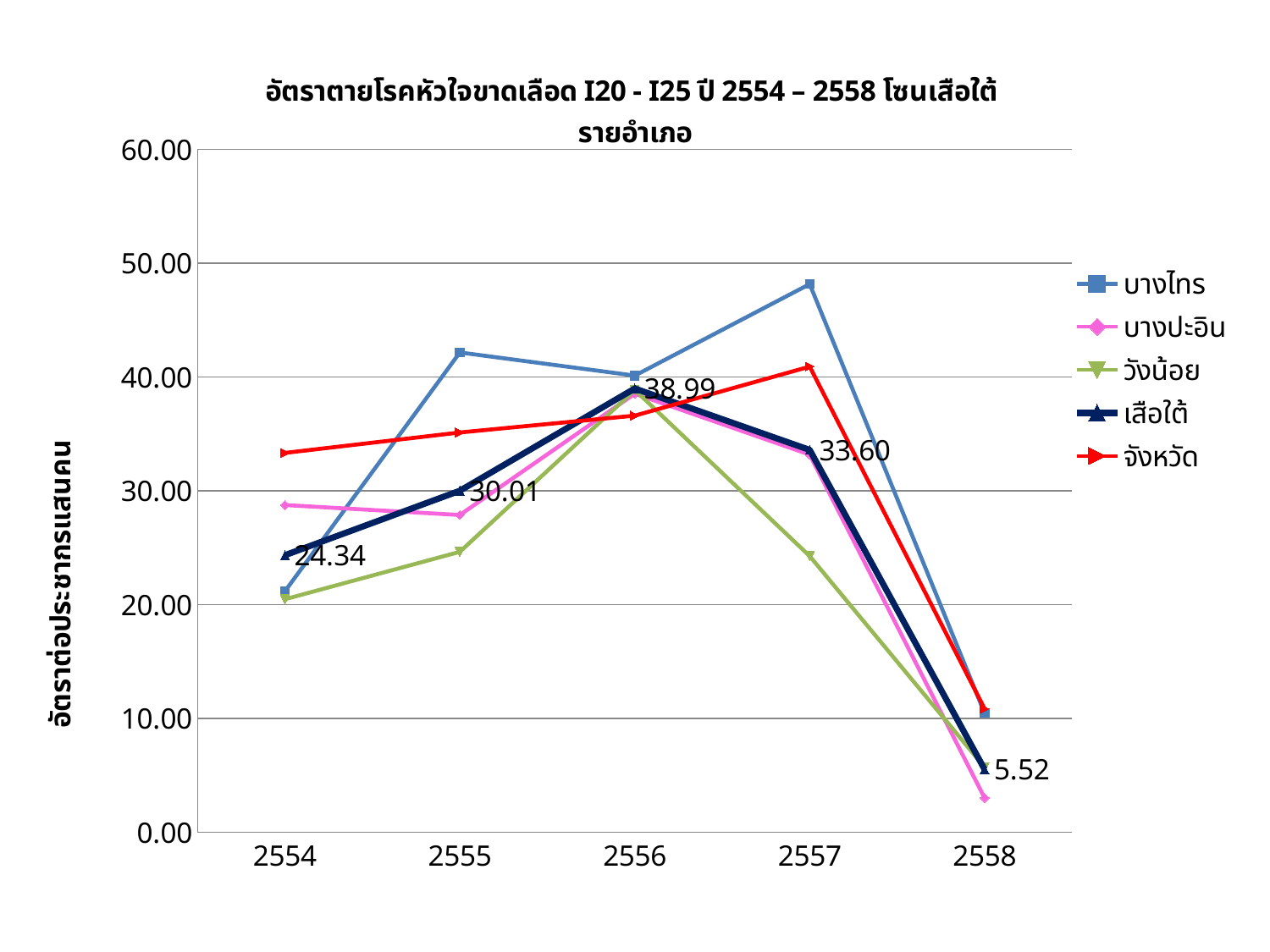
Which is larger for เสือใต้: the value in 2555 or the value in 2557? 2557 How many series does the legend list? 5 How many years are shown on the x axis? 5 What is the value for เสือใต้ in 2554? 24.34 Is the value for บางปะอิน in 2558 greater or less than 10? less In which year is the value for เสือใต้ highest? 2556 What kind of chart is shown on the slide? line chart What is the value for เสือใต้ in 2556? 38.99 Is the value for บางไทร in 2557 greater or less than 40? greater In which year is the value for เสือใต้ lowest? 2558 What is the difference between the เสือใต้ values for 2556 and 2557? 5.39 What is the value for เสือใต้ in 2558? 5.52